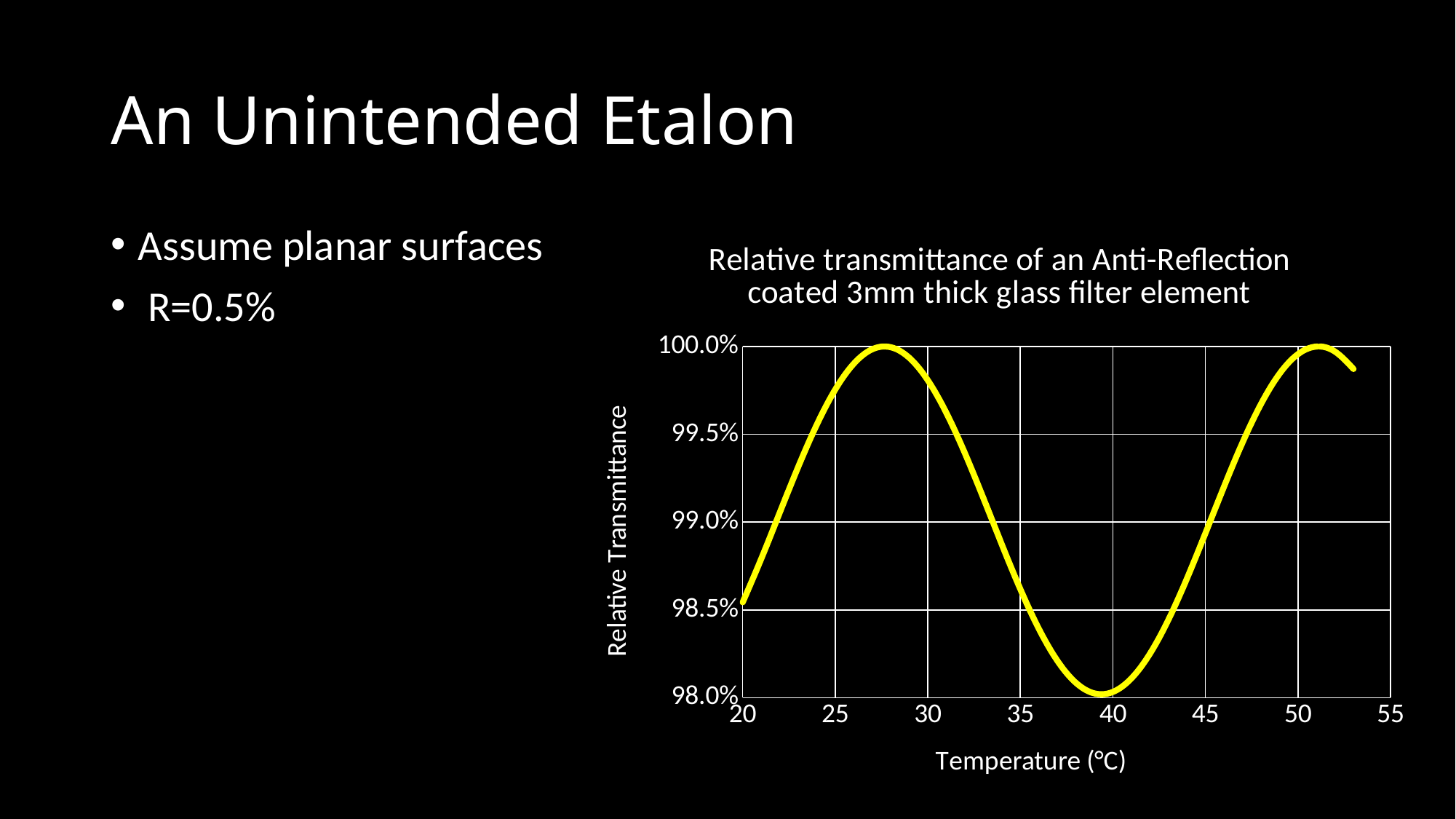
What is the label of the x axis of the chart? Temperature (°C) Does the relative transmittance rise or fall as temperature increases from 40°C to 50°C? rise Is the relative transmittance at 30°C greater or less than 99.5%? greater What kind of chart is shown on the slide? Line chart Is the relative transmittance at 50°C greater or less than 99.5%? greater Is the relative transmittance at 40°C greater or less than 99.0%? less Which has the lower relative transmittance, 20°C or 50°C? 20°C Which has the higher relative transmittance, 30°C or 40°C? 30°C Does the relative transmittance rise or fall as temperature increases from 30°C to 40°C? fall What is the title of the chart? Relative transmittance of an Anti-Reflection coated 3mm thick glass filter element